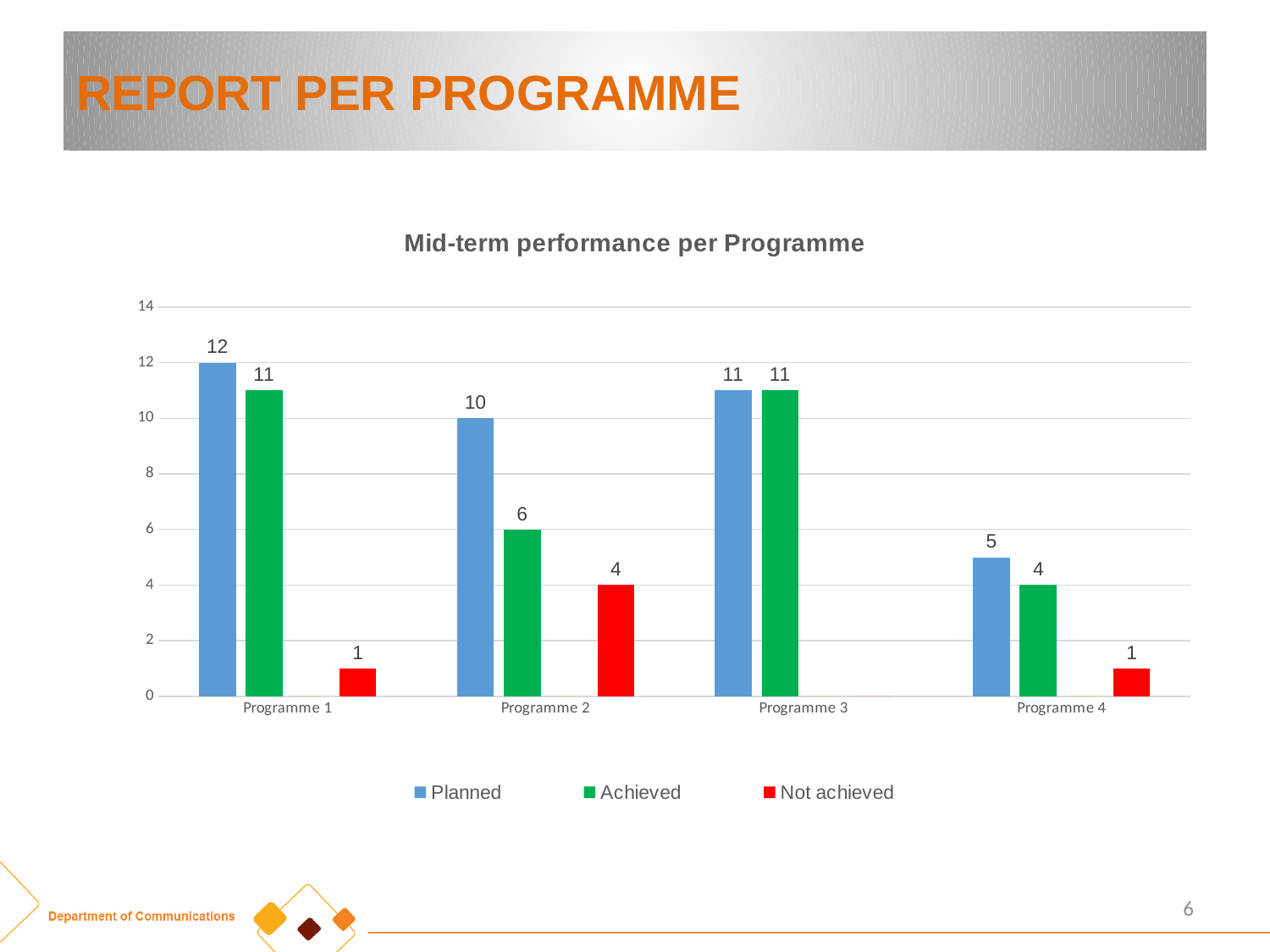
Which is larger, the Planned value for Programme 3 or the Planned value for Programme 4? Programme 3 Which programme has the highest Planned value? Programme 1 Which programme has the lowest Achieved value? Programme 4 What is the Achieved value for Programme 4? 4 What is the Planned value for Programme 1? 12 How many series does the legend list? 3 What is the title of the chart? Mid-term performance per Programme What is the difference between the Planned and Achieved values for Programme 2? 4 What kind of chart is shown on the slide? Bar chart What is the Not achieved value for Programme 2? 4 What is the Achieved value for Programme 2? 6 How many programmes are shown on the x axis? 4